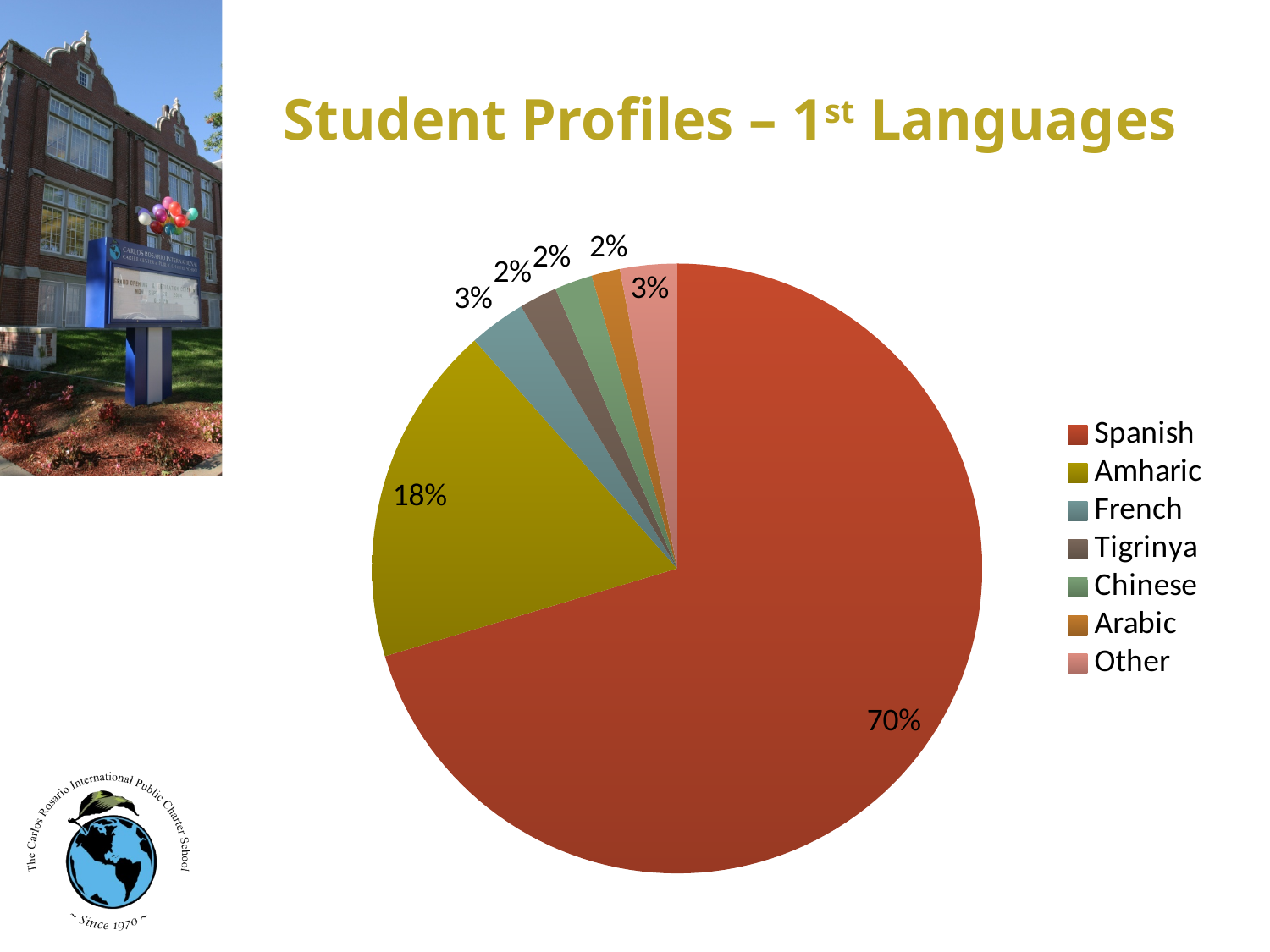
What share of the pie does French represent? 3% What is the difference between the Spanish share and the Amharic share? 52% What share of the pie does Other represent? 3% What share of the pie does Tigrinya represent? 2% Which language has the largest slice of the pie? Spanish What share of the pie does Amharic represent? 18% How many languages are listed in the legend? 7 What type of chart is shown on the slide? pie chart Which language is shown in the yellow-olive colour in the legend? Amharic What is the title of the slide containing the chart? Student Profiles – 1st Languages Which is larger, the share for Amharic or the share for French? Amharic What share of the pie does Spanish represent? 70%